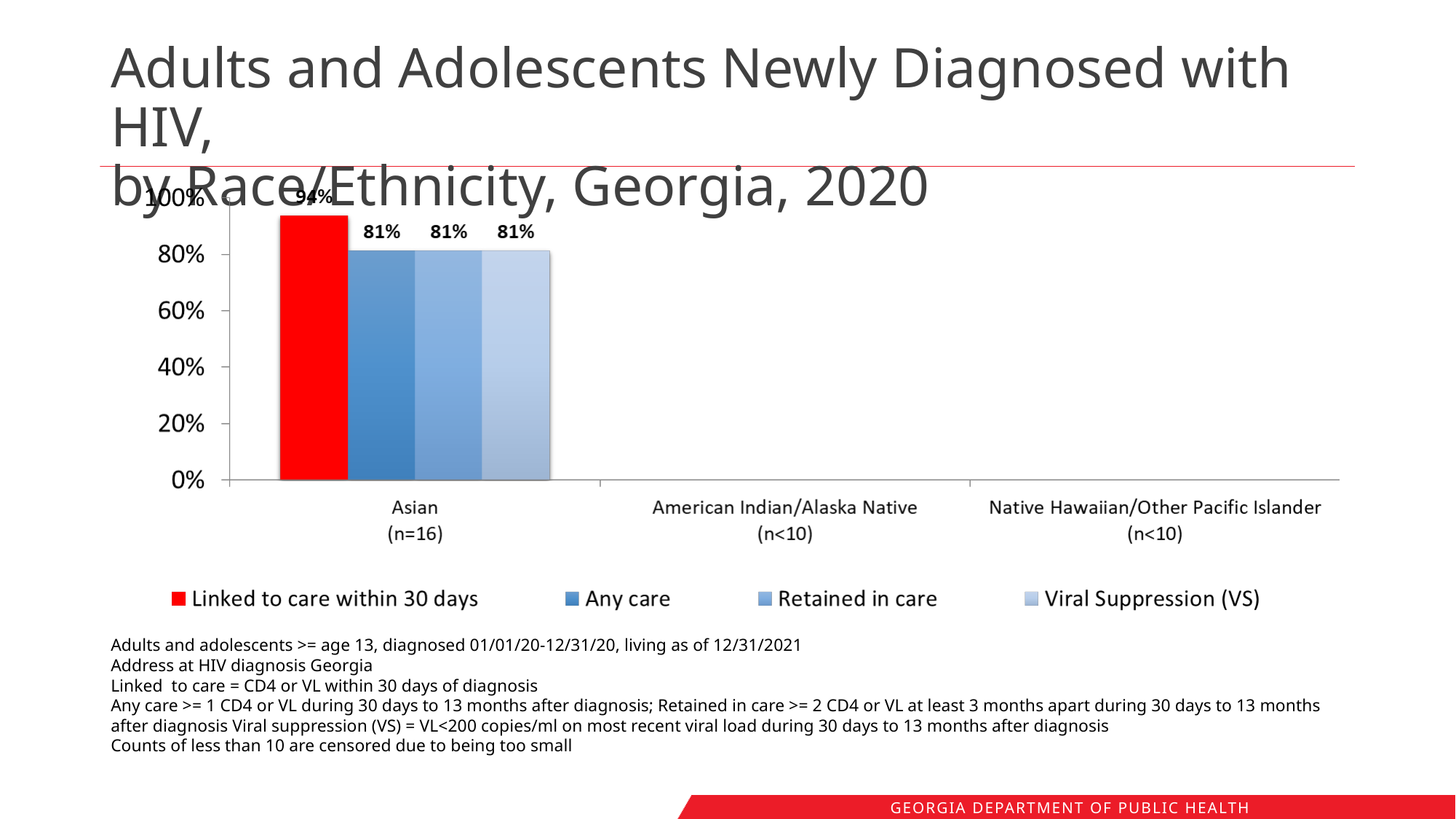
What is the value for Viral Suppression (VS) for the Asian group? 81% Is the value for Retained in care for the Asian group greater or less than 60%? greater How many race/ethnicity categories are shown on the x axis? 3 What kind of chart is shown on the slide? bar chart Which series has the highest value for the Asian group? Linked to care within 30 days What is the sample size shown for the Asian group? n=16 Which is larger for the Asian group, Linked to care within 30 days or Any care? Linked to care within 30 days What is the value for Linked to care within 30 days for the Asian group? 94% What is the value for Any care for the Asian group? 81% Which colour represents Linked to care within 30 days in the legend? red What is the difference between Linked to care within 30 days and Retained in care for the Asian group? 13% How many series does the legend list? 4